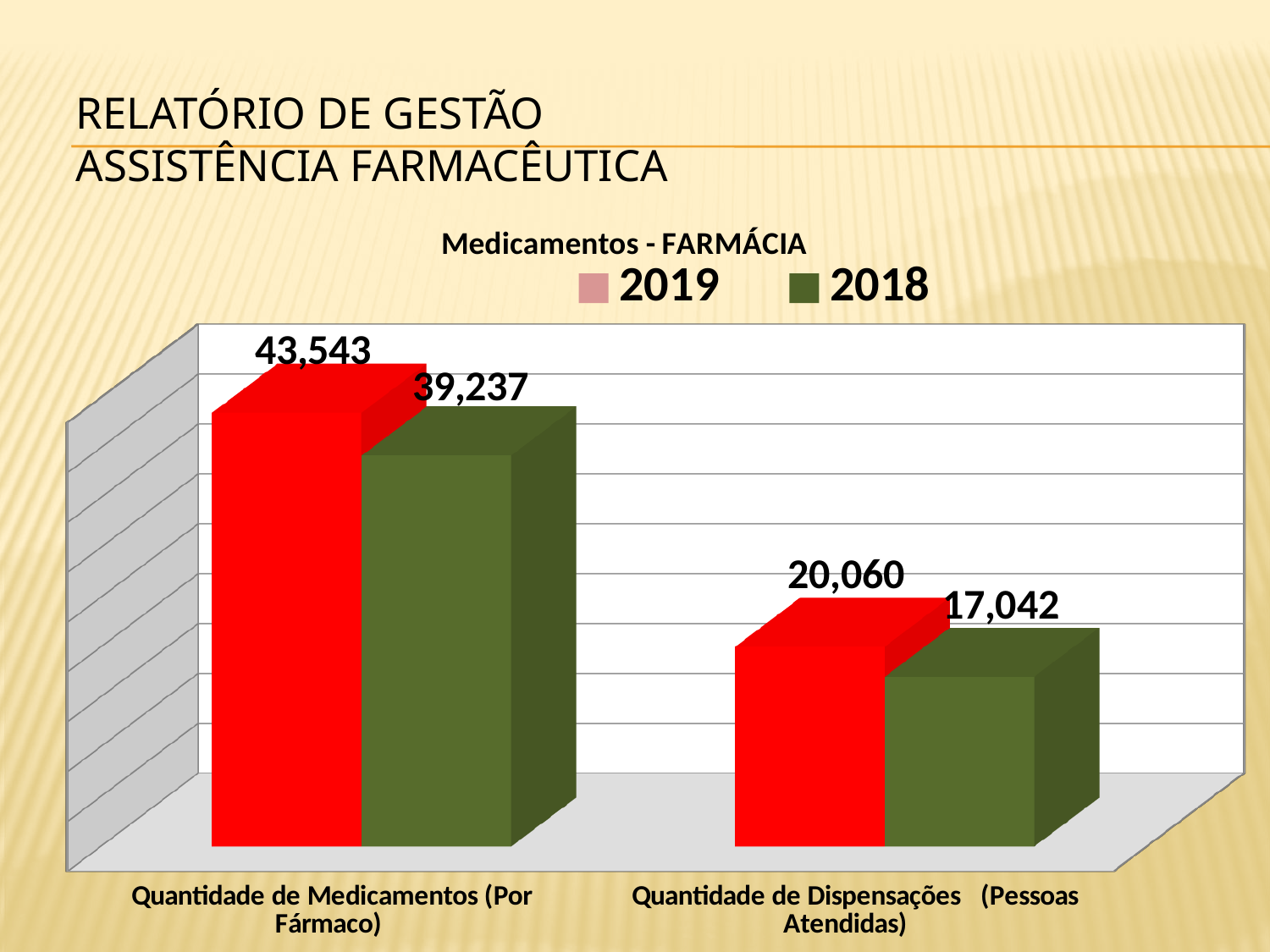
What is the 2018 value for Quantidade de Dispensações (Pessoas Atendidas)? 17,042 Which bar has the highest value on the chart? 2019, Quantidade de Medicamentos (Por Fármaco) Which is larger for Quantidade de Dispensações (Pessoas Atendidas): the 2019 value or the 2018 value? 2019 What type of chart is shown on the slide? Bar chart What is the 2019 value for Quantidade de Medicamentos (Por Fármaco)? 43,543 What is the difference between the 2019 and 2018 values for Quantidade de Dispensações (Pessoas Atendidas)? 3,018 Which bar has the lowest value on the chart? 2018, Quantidade de Dispensações (Pessoas Atendidas) What is the 2019 value for Quantidade de Dispensações (Pessoas Atendidas)? 20,060 How many categories are shown on the x axis? 2 How many series does the legend list? 2 What is the difference between the 2019 and 2018 values for Quantidade de Medicamentos (Por Fármaco)? 4,306 What is the 2018 value for Quantidade de Medicamentos (Por Fármaco)? 39,237